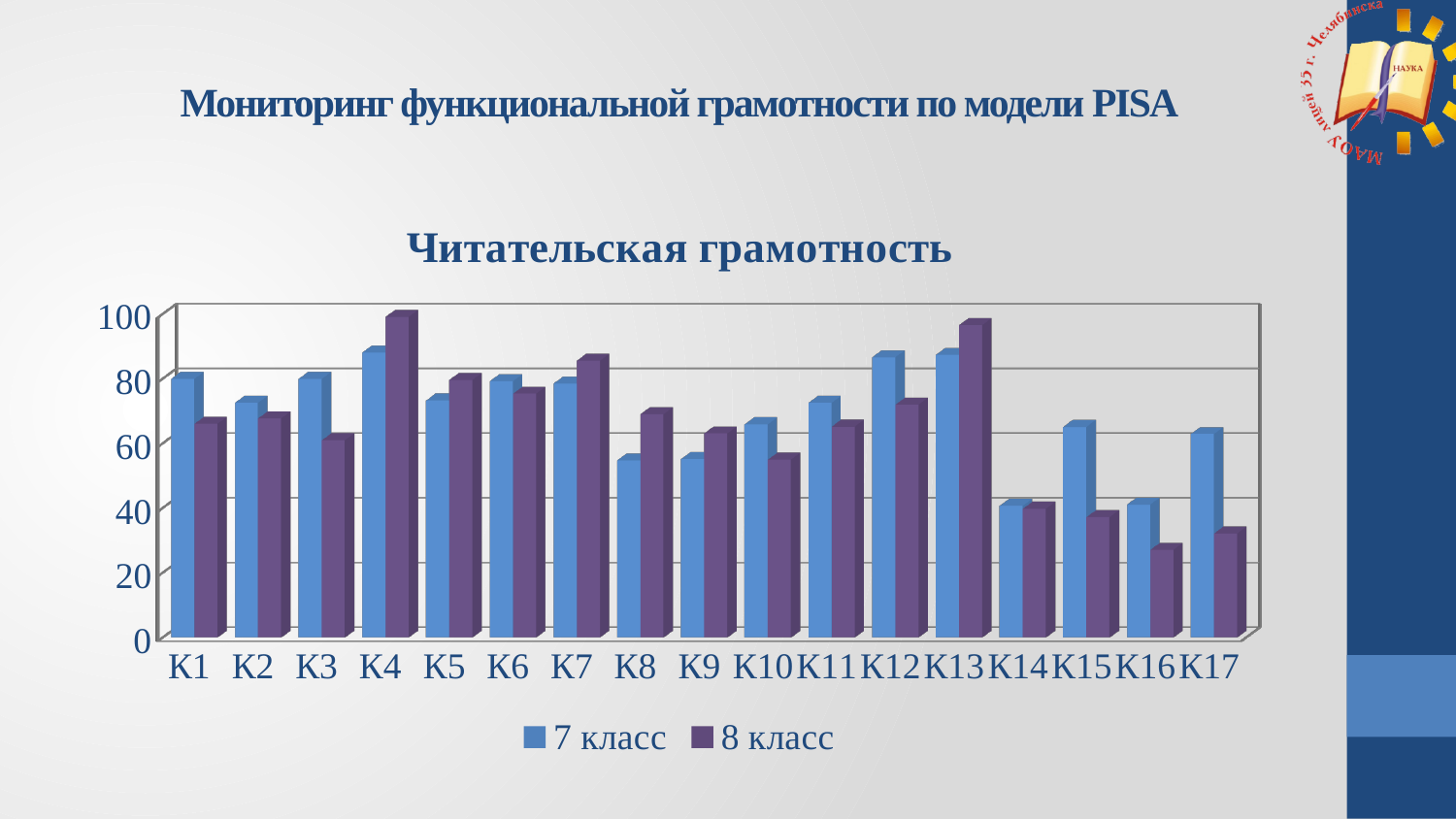
Is the value for 7 класс at K4 greater or less than 80? greater Is the value for 8 класс at K16 greater or less than 40? less What kind of chart is shown on the slide? bar chart How many categories are shown on the x axis? 17 Is the value for 8 класс at K13 greater or less than 80? greater For K17, which series has the larger value, 7 класс or 8 класс? 7 класс For K4, which series has the larger value, 7 класс or 8 класс? 8 класс Which category has the lowest value for 8 класс? K16 What is the title of the chart? Читательская грамотность How many series does the legend list? 2 Which series is shown in purple? 8 класс